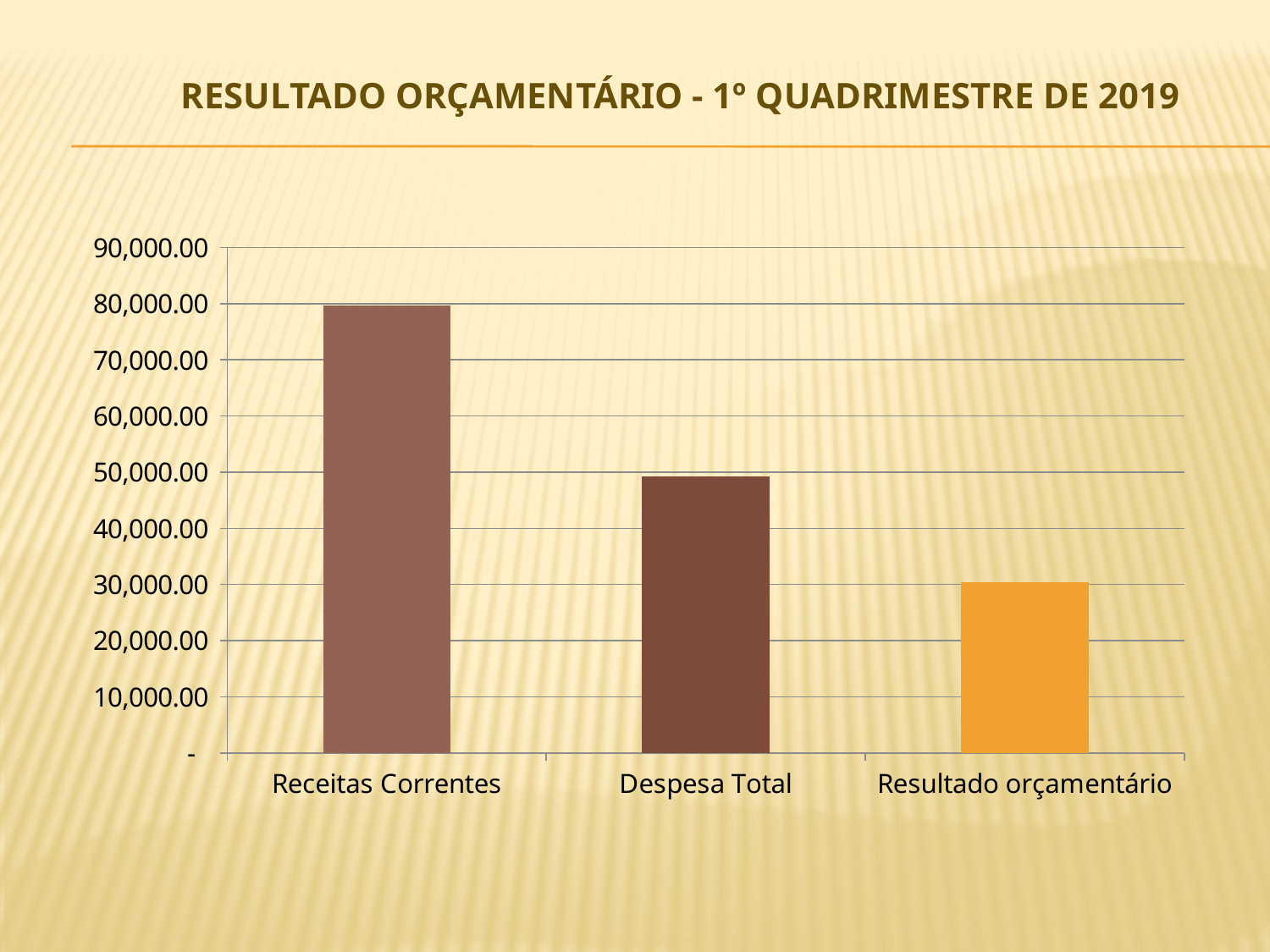
Is the value for Resultado orçamentário greater or less than 40,000.00? less Which category has the lowest value in the chart? Resultado orçamentário Is the value for Receitas Correntes greater or less than 70,000.00? greater Which category has the highest value in the chart? Receitas Correntes Do the bar values rise or fall from left to right across the x axis? fall Is the value for Receitas Correntes greater or less than 90,000.00? less Which is larger, Receitas Correntes or Despesa Total? Receitas Correntes What kind of chart is shown on the slide? bar chart Which is larger, Despesa Total or Resultado orçamentário? Despesa Total How many categories are shown on the x axis of the chart? 3 What is the title of the chart on the slide? RESULTADO ORÇAMENTÁRIO - 1º QUADRIMESTRE DE 2019